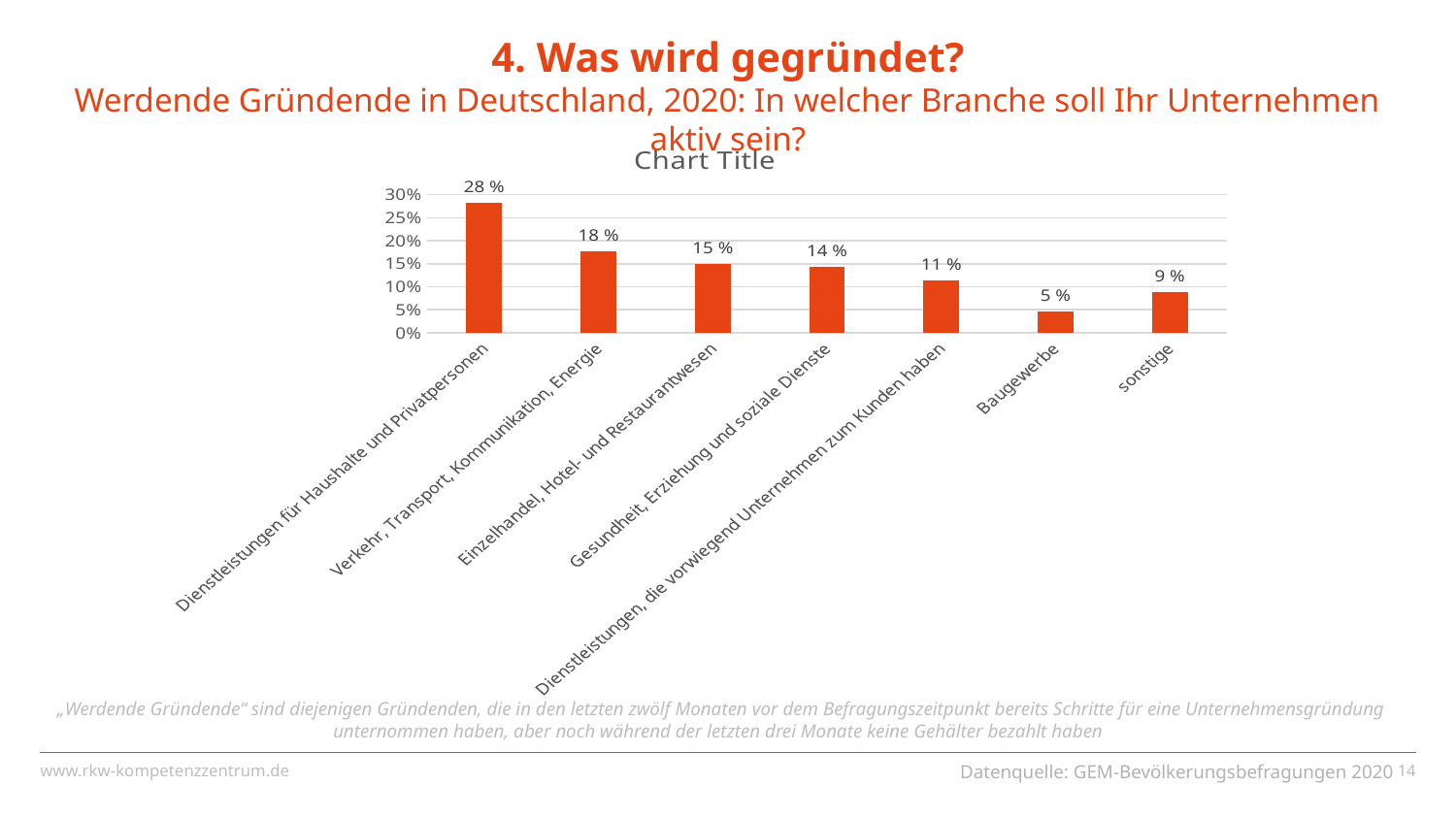
Which category has the highest value? Dienstleistungen für Haushalte und Privatpersonen What kind of chart is shown on the slide? bar chart Which category has the lowest value? Baugewerbe What is the value for sonstige? 9 % What is the value for Verkehr, Transport, Kommunikation, Energie? 18 % Which is larger: Dienstleistungen, die vorwiegend Unternehmen zum Kunden haben or sonstige? Dienstleistungen, die vorwiegend Unternehmen zum Kunden haben What is the value for Einzelhandel, Hotel- und Restaurantwesen? 15 % How many categories are shown in the chart? 7 What is the value for Baugewerbe? 5 % Is the value for Gesundheit, Erziehung und soziale Dienste greater or less than 10%? greater What is the difference between Dienstleistungen für Haushalte und Privatpersonen and Gesundheit, Erziehung und soziale Dienste? 14 % What is the title printed directly above the chart? Chart Title